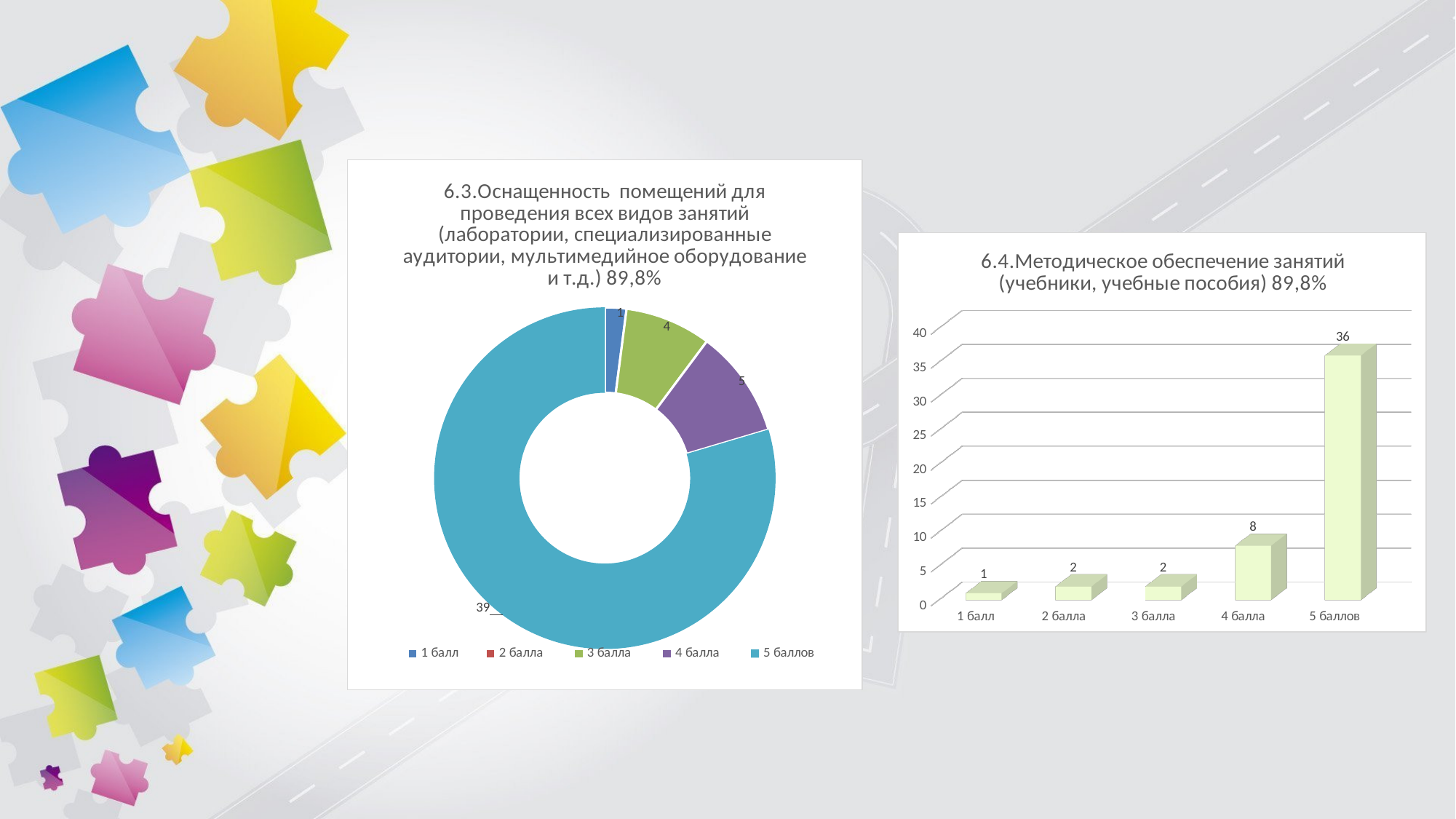
In the chart titled "6.4.Методическое обеспечение занятий", what is the difference between the values for 5 баллов and 4 балла? 28 In the chart titled "6.4.Методическое обеспечение занятий", how many categories are shown on the x axis? 5 What kind of chart is the one titled "6.3.Оснащенность помещений"? doughnut chart In the chart titled "6.4.Методическое обеспечение занятий", what is the value for 4 балла? 8 In the chart titled "6.4.Методическое обеспечение занятий", which category has the lowest value? 1 балл In the chart titled "6.4.Методическое обеспечение занятий", what is the value for 5 баллов? 36 In the chart titled "6.4.Методическое обеспечение занятий", do the values rise or fall from 1 балл to 5 баллов? rise How many entries does the legend of the chart titled "6.3.Оснащенность помещений" list? 5 In the chart titled "6.3.Оснащенность помещений", what is the value for 5 баллов? 39 What kind of chart is the one titled "6.4.Методическое обеспечение занятий"? bar chart In the chart titled "6.3.Оснащенность помещений", what is the value for 3 балла? 4 In the chart titled "6.3.Оснащенность помещений", which is larger, the value for 4 балла or the value for 1 балл? 4 балла